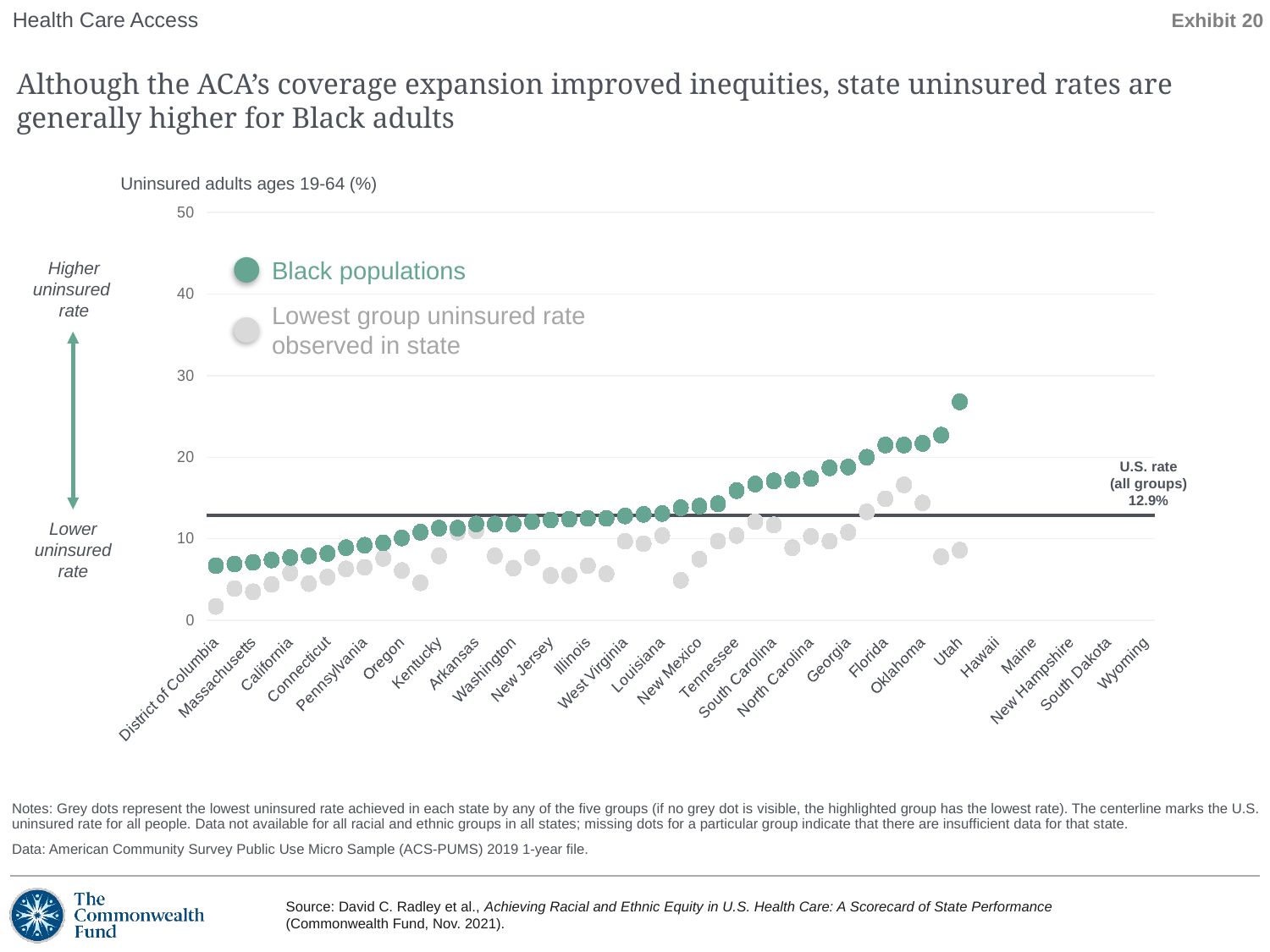
Is the uninsured rate for Black populations in Utah greater or less than 20? greater Do the uninsured rates for Black populations rise or fall from left to right along the x axis? rise Is the uninsured rate for Black populations in District of Columbia greater or less than 10? less Which labeled state has the highest uninsured rate for Black populations? Utah Which has a higher uninsured rate for Black populations, Utah or District of Columbia? Utah What kind of chart is shown on the slide? Dot (scatter) chart Which labeled state has the lowest uninsured rate for Black populations? District of Columbia Is the uninsured rate for Black populations in Massachusetts greater or less than 10? less What is the U.S. uninsured rate for all groups marked by the centerline? 12.9% What does the grey dot represent according to the legend? Lowest group uninsured rate observed in state How many series does the chart legend list? 2